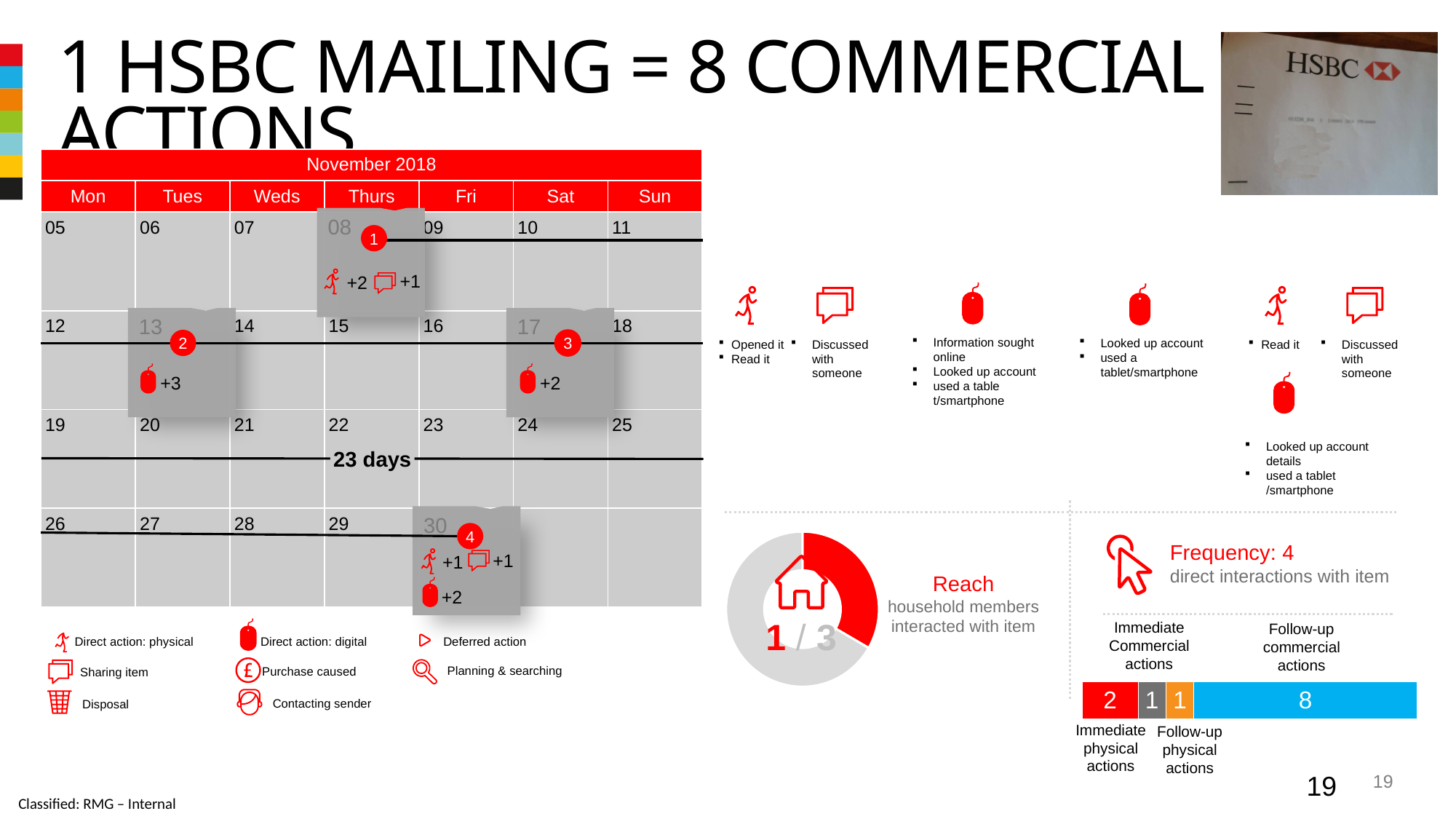
In the stacked bar chart at the bottom right, which is larger: immediate physical actions or follow-up commercial actions? Follow-up commercial actions In the stacked bar chart at the bottom right, what value is shown for follow-up commercial actions? 8 In the stacked bar chart at the bottom right, what colour is the segment for follow-up commercial actions? Blue In the Reach donut chart, what fraction of household members interacted with the item? 1 / 3 In the stacked bar chart at the bottom right, how many segments make up the bar? 4 In the stacked bar chart at the bottom right, what colour is the segment for immediate physical actions? Red In the stacked bar chart at the bottom right, what is the difference between follow-up commercial actions and immediate physical actions? 6 What kind of chart is used to show the Reach of household members who interacted with the item? Donut chart In the stacked bar chart at the bottom right, what value is shown for immediate physical actions? 2 In the stacked bar chart at the bottom right, which segment has the highest value? Follow-up commercial actions What kind of chart is used at the bottom right to show the commercial and physical actions? Stacked bar chart In the stacked bar chart at the bottom right, what is the total of all four segments? 12